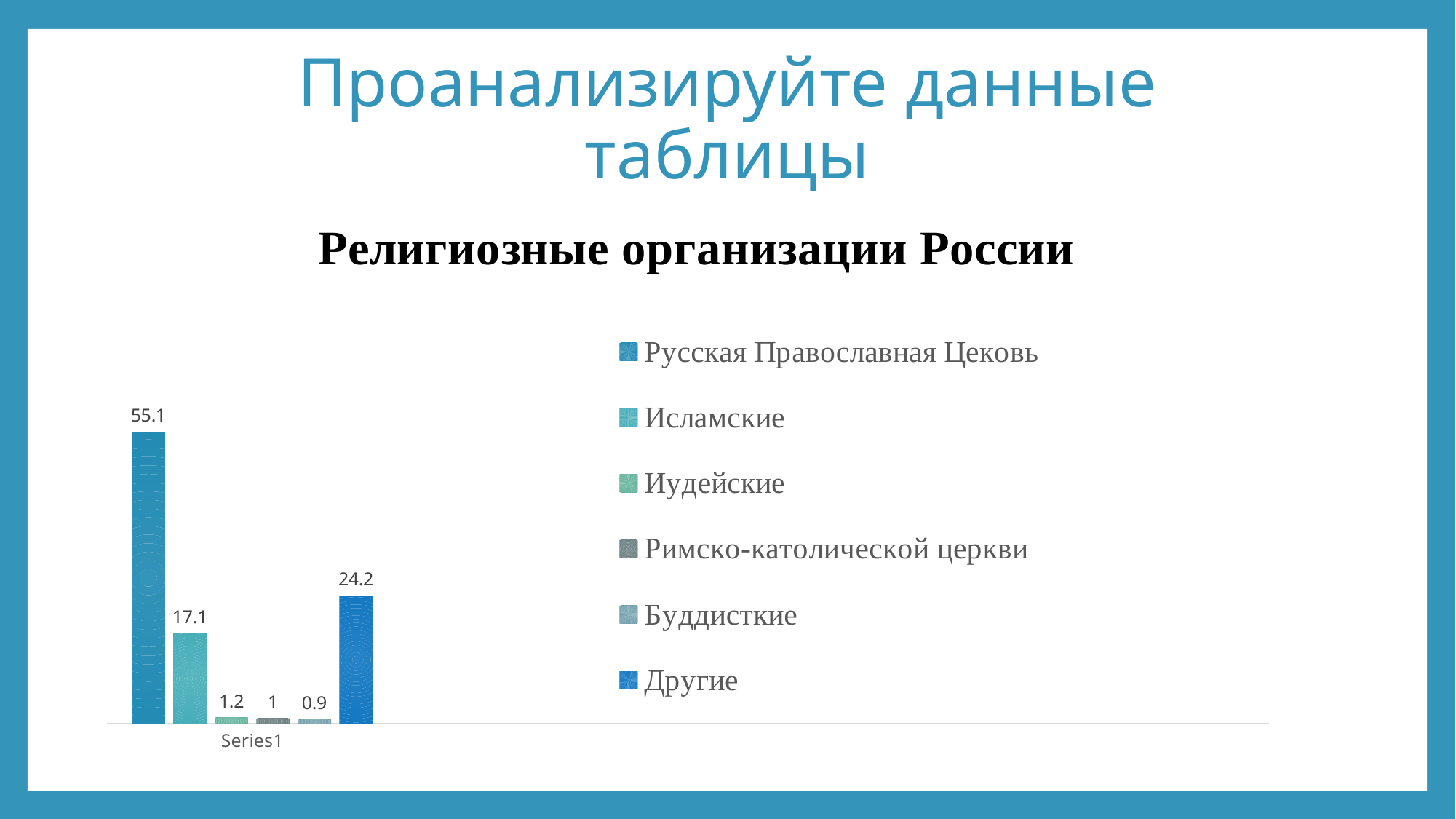
What is the difference between the values for Русская Православная Цековь and Другие? 30.9 What value is shown for Исламские? 17.1 Which legend entry has the lowest value? Буддисткие What is the title of the chart? Религиозные организации России What is the difference between the values for Исламские and Иудейские? 15.9 What kind of chart is shown on the slide? Bar chart How many series does the legend list? 6 Which is larger, the value for Другие or the value for Исламские? Другие What value is shown for Другие? 24.2 What value is shown for Буддистские? 0.9 What value is shown for Русская Православная Цековь? 55.1 Which legend entry has the highest value? Русская Православная Цековь